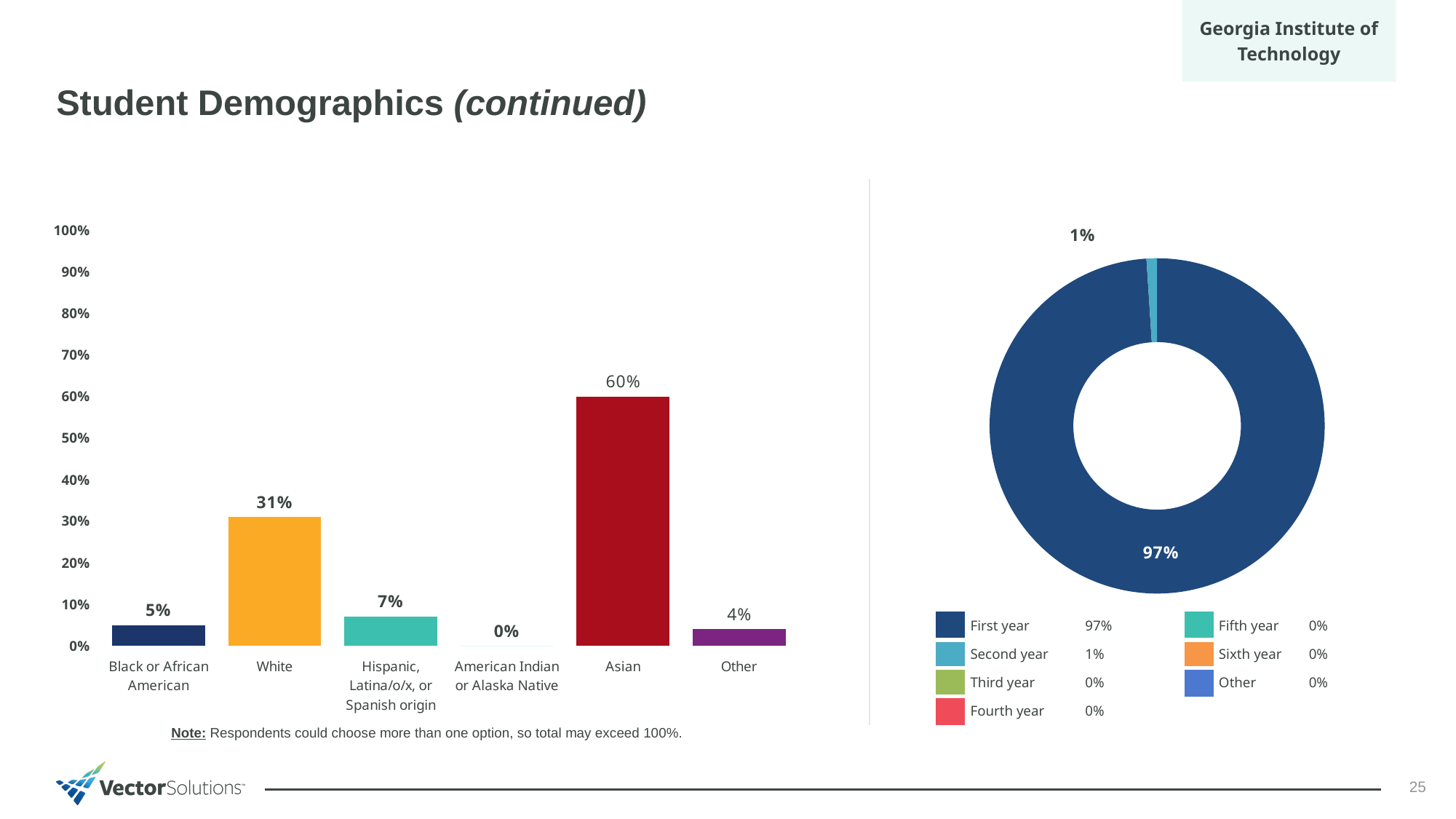
In the bar chart on the left, what is the difference between the values for Asian and White? 29% In the bar chart on the left, which category has the lowest value? American Indian or Alaska Native How many entries does the legend of the donut chart on the right list? 7 In the bar chart on the left, which category has the highest value? Asian In the bar chart on the left, what is the value for White? 31% In the bar chart on the left, what is the value for Hispanic, Latina/o/x, or Spanish origin? 7% In the bar chart on the left, what is the value for Asian? 60% In the donut chart on the right, what is the value for Second year? 1% In the bar chart on the left, which is larger, the value for Black or African American or the value for Other? Black or African American What kind of chart is on the left side of the slide? Bar chart How many categories are shown in the bar chart on the left? 6 In the donut chart on the right, what is the share for First year? 97%